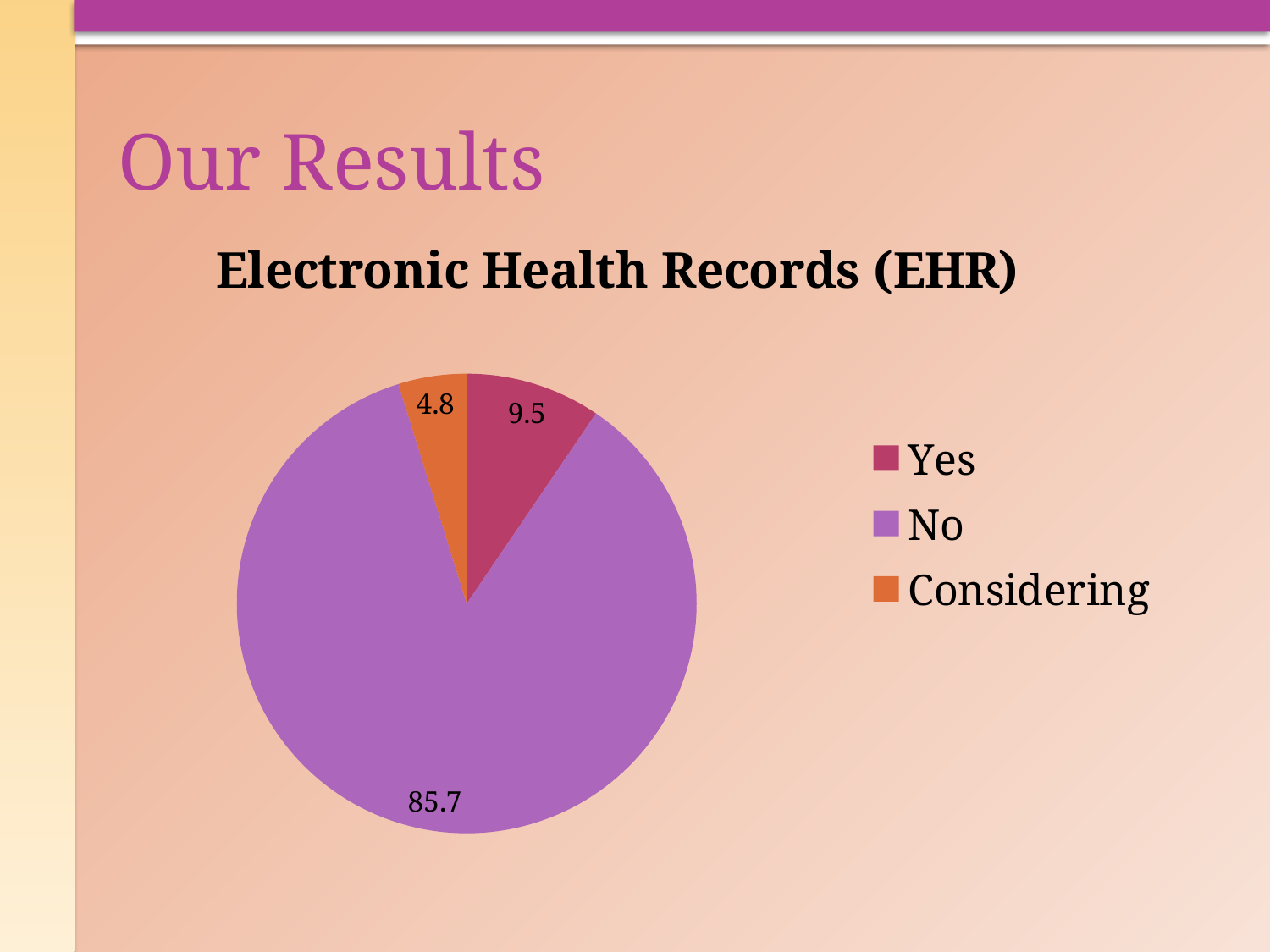
Which is larger, the Yes slice or the Considering slice? Yes How many slices does the pie chart have? 3 What kind of chart is shown on the slide? Pie chart What is the value for the Yes slice? 9.5 What is the title of the chart? Electronic Health Records (EHR) What is the difference between the No value and the Yes value? 76.2 What is the value for the No slice? 85.7 Which category has the largest slice? No Which category has the smallest slice? Considering What is the value for the Considering slice? 4.8 What is the difference between the Yes value and the Considering value? 4.7 How many entries does the legend list? 3